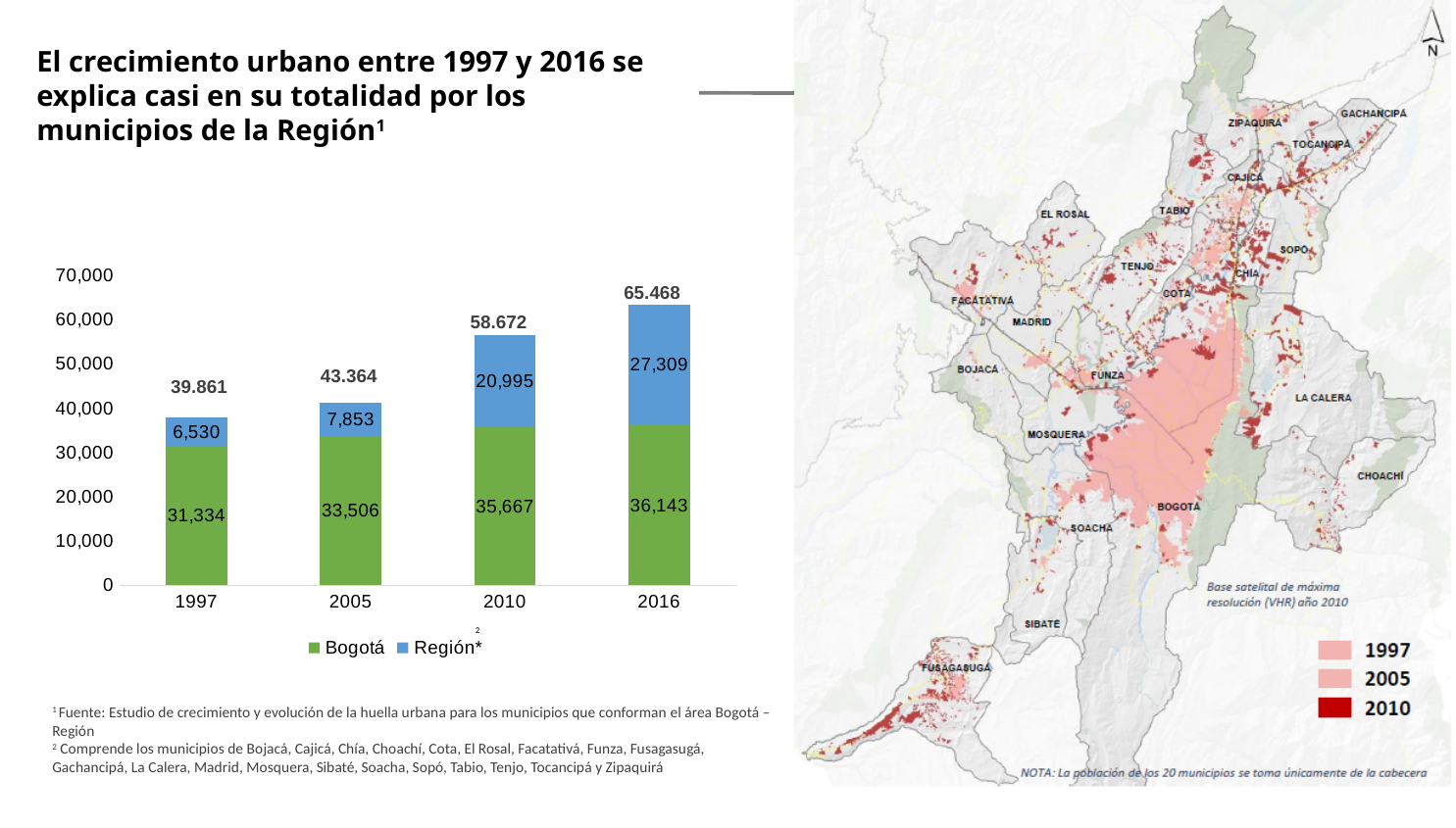
How many series does the legend of the bar chart list? 2 What is the value for Región* in 2010? 20,995 What kind of chart is shown on the left of the slide? Stacked bar chart What is the value for Bogotá in 1997? 31,334 Which is larger: the Bogotá value in 2016 or the Bogotá value in 2010? 2016 In which year is the Región* value highest? 2016 What is the value for Región* in 2016? 27,309 What is the total shown above the stacked bar for 2016? 65.468 What is the difference between the Región* values for 2010 and 2005? 13,142 What is the total shown above the stacked bar for 2005? 43.364 In which year is the Bogotá value lowest? 1997 How many years are shown on the x axis of the bar chart? 4